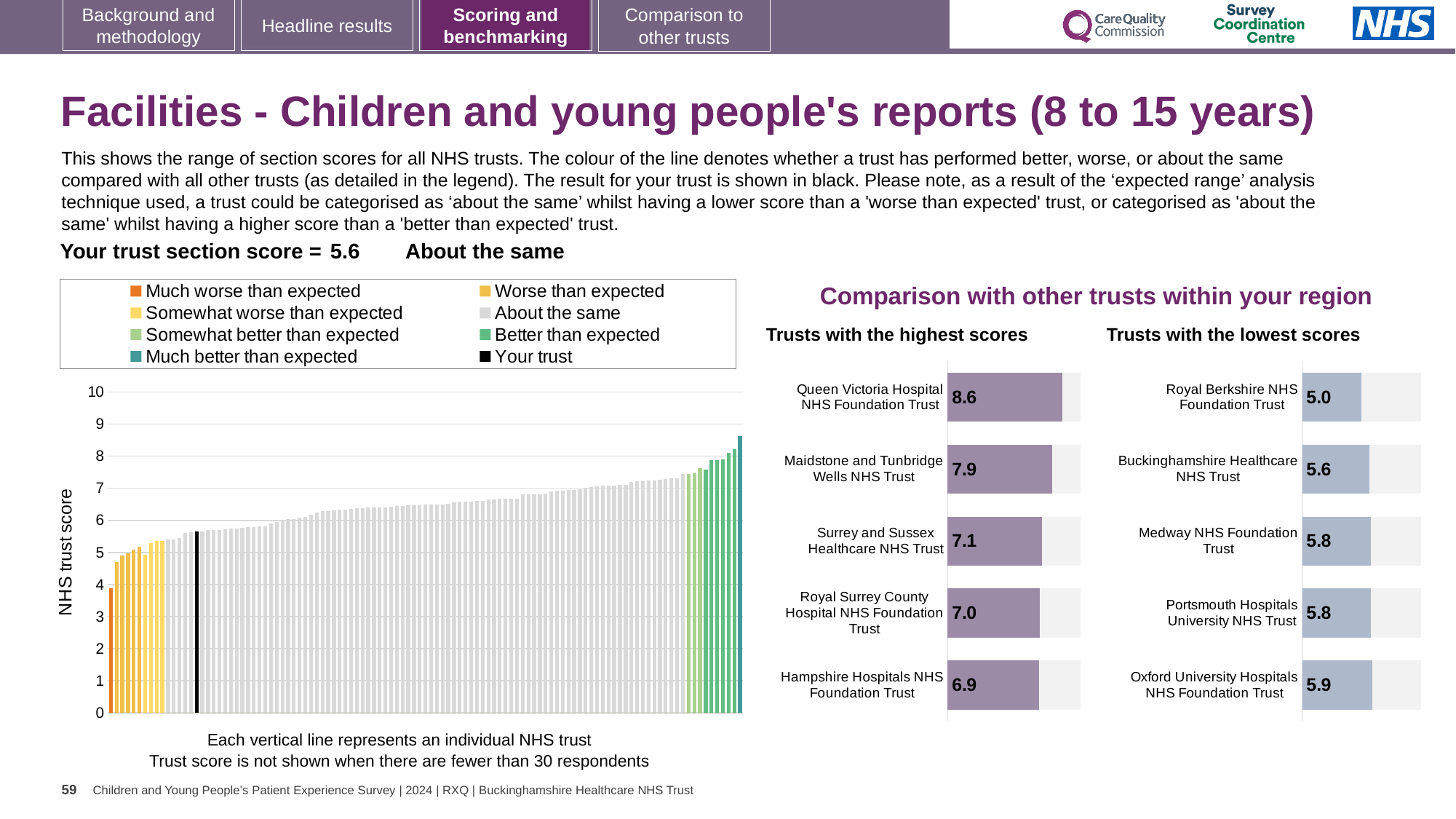
How many trusts are shown in the 'Trusts with the highest scores' chart? 5 In the 'Trusts with the lowest scores' chart, what is the score for Royal Berkshire NHS Foundation Trust? 5.0 In the 'Trusts with the highest scores' chart, which trust has the highest score? Queen Victoria Hospital NHS Foundation Trust In the 'Trusts with the highest scores' chart, what is the difference between the scores of Queen Victoria Hospital NHS Foundation Trust and Maidstone and Tunbridge Wells NHS Trust? 0.7 In the 'Trusts with the highest scores' chart, which has the larger score: Surrey and Sussex Healthcare NHS Trust or Royal Surrey County Hospital NHS Foundation Trust? Surrey and Sussex Healthcare NHS Trust In the 'NHS trust score' chart on the left, do the values rise or fall from left to right? rise In the 'NHS trust score' chart on the left, is the value for your trust (the black bar) greater or less than 6? less What kind of chart is the 'NHS trust score' chart on the left of the slide? bar chart In the 'Trusts with the highest scores' chart, what is the score for Hampshire Hospitals NHS Foundation Trust? 6.9 In the 'Trusts with the lowest scores' chart, what is the score for Oxford University Hospitals NHS Foundation Trust? 5.9 In the 'Trusts with the lowest scores' chart, which trust has the lowest score? Royal Berkshire NHS Foundation Trust In the 'Trusts with the highest scores' chart, what is the score for Queen Victoria Hospital NHS Foundation Trust? 8.6